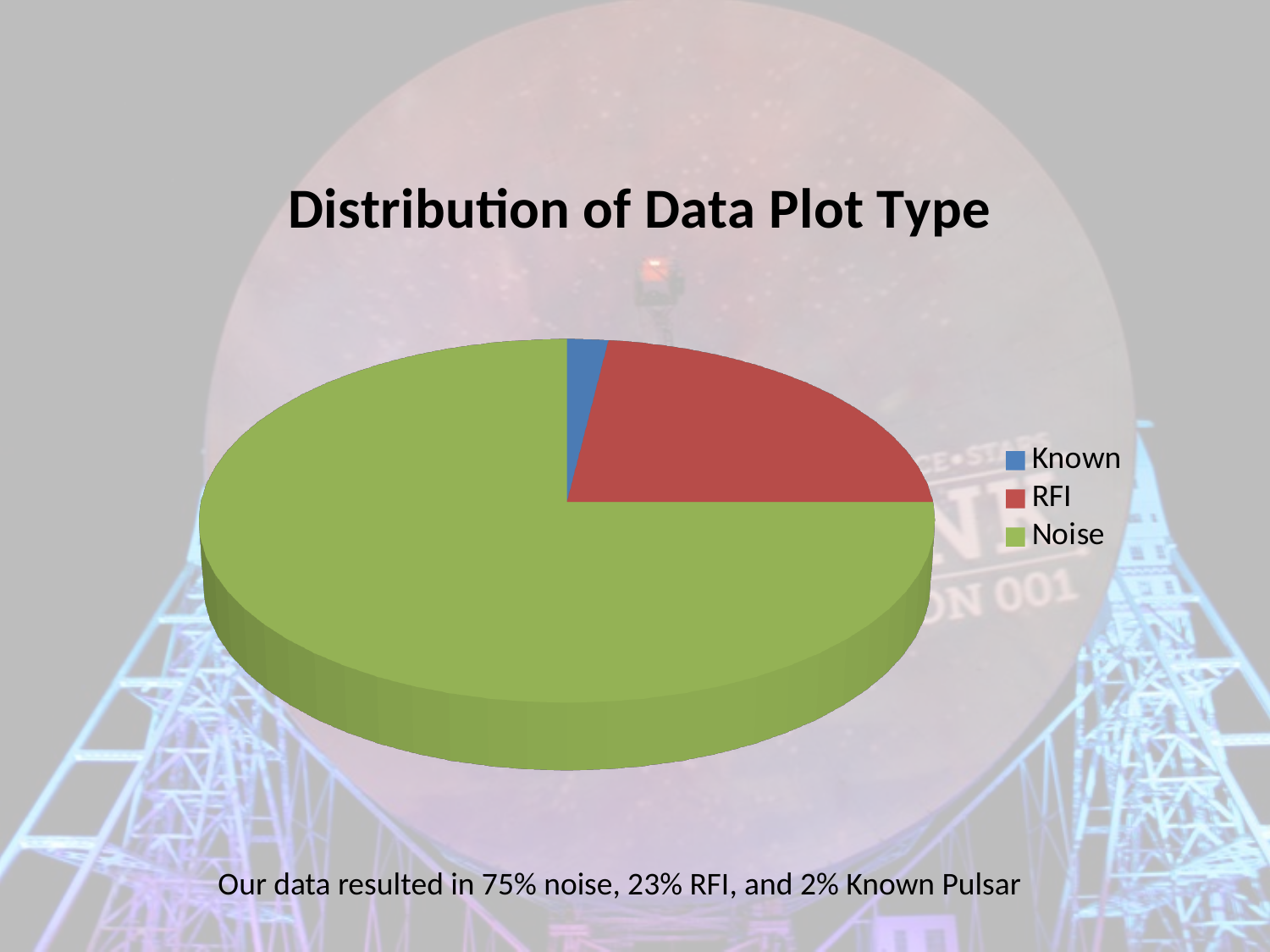
Which slice is larger, RFI or Known? RFI What share of the pie does Known represent? 2% Which category has the smallest slice of the pie? Known Which slice is larger, Noise or RFI? Noise What share of the pie does Noise represent? 75% What colour is the Noise slice in the pie chart? green How many categories does the legend of the pie chart list? 3 What kind of chart is shown on the slide? pie chart What share of the pie does RFI represent? 23% What is the difference in percentage points between the Noise share and the RFI share? 52% What is the title of the chart? Distribution of Data Plot Type Which category has the largest slice of the pie? Noise